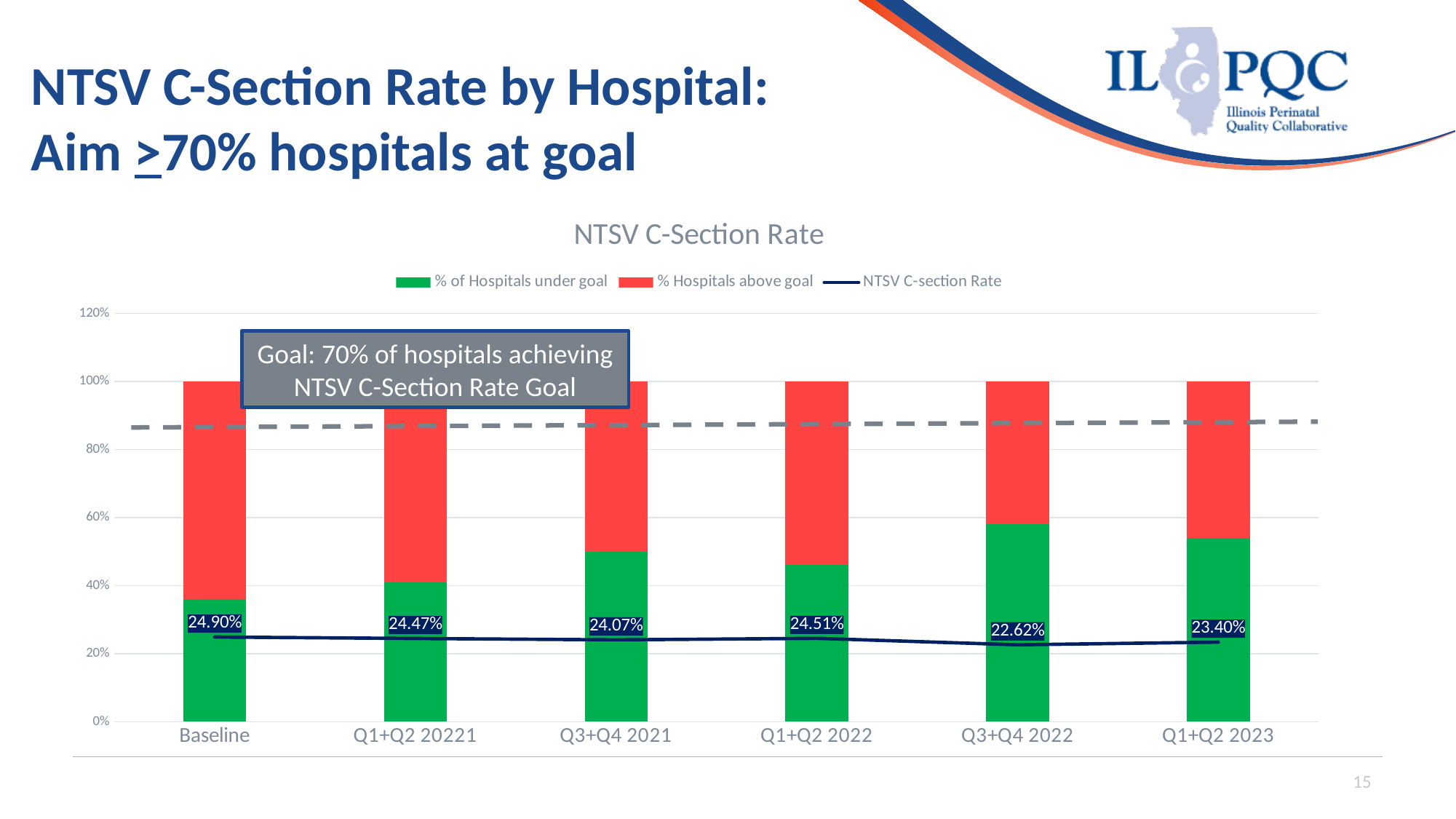
Which period has the highest % of Hospitals under goal? Q3+Q4 2022 What is the NTSV C-section Rate for Q1+Q2 2023? 23.40% Which period has the highest NTSV C-section Rate? Baseline How many periods are shown on the x axis? 6 Is the % of Hospitals under goal at Baseline greater or less than 40%? less Which is larger, the NTSV C-section Rate at Baseline or in Q1+Q2 2023? Baseline How many series does the legend list? 3 Which period has the lowest NTSV C-section Rate? Q3+Q4 2022 Is the % of Hospitals under goal in Q3+Q4 2022 greater or less than 40%? greater What is the NTSV C-section Rate at Baseline? 24.90% What is the NTSV C-section Rate for Q3+Q4 2022? 22.62% What is the difference between the NTSV C-section Rate at Baseline and in Q3+Q4 2022? 2.28%